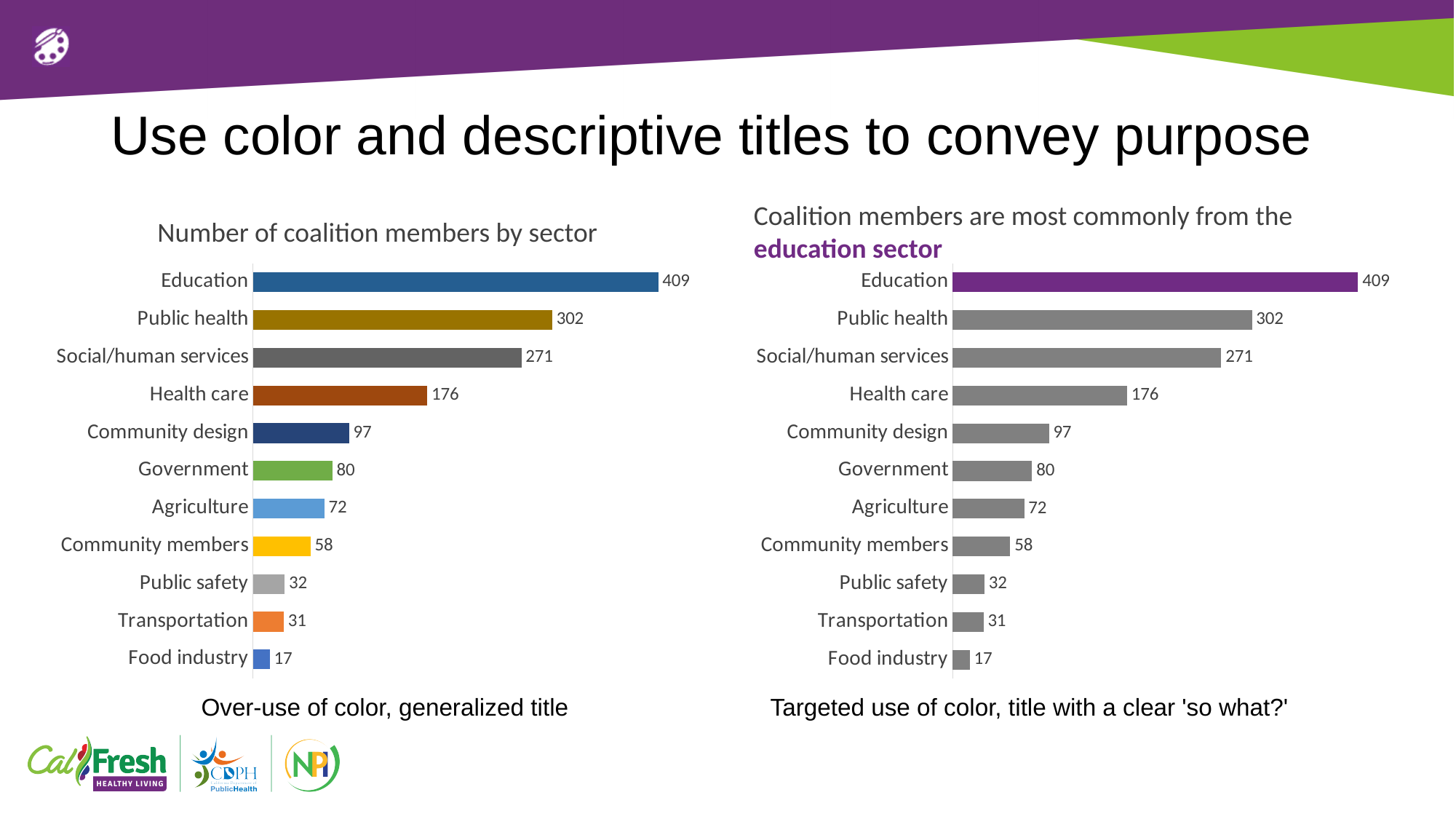
In the right chart titled 'Coalition members are most commonly from the education sector', what is the value for Community design? 97 In the left chart titled 'Number of coalition members by sector', what is the value for Public health? 302 In the left chart titled 'Number of coalition members by sector', what is the value for Health care? 176 In the left chart titled 'Number of coalition members by sector', what is the difference between Education and Public health? 107 What kind of chart is the left chart titled 'Number of coalition members by sector'? Bar chart How many sectors are shown in the right chart titled 'Coalition members are most commonly from the education sector'? 11 In the left chart titled 'Number of coalition members by sector', which sector has the highest value? Education In the right chart titled 'Coalition members are most commonly from the education sector', which sector has the lowest value? Food industry In the right chart titled 'Coalition members are most commonly from the education sector', what is the difference between Social/human services and Health care? 95 What is the title of the left chart? Number of coalition members by sector In the left chart titled 'Number of coalition members by sector', which is larger, Government or Agriculture? Government In the right chart titled 'Coalition members are most commonly from the education sector', which bar is colored purple? Education